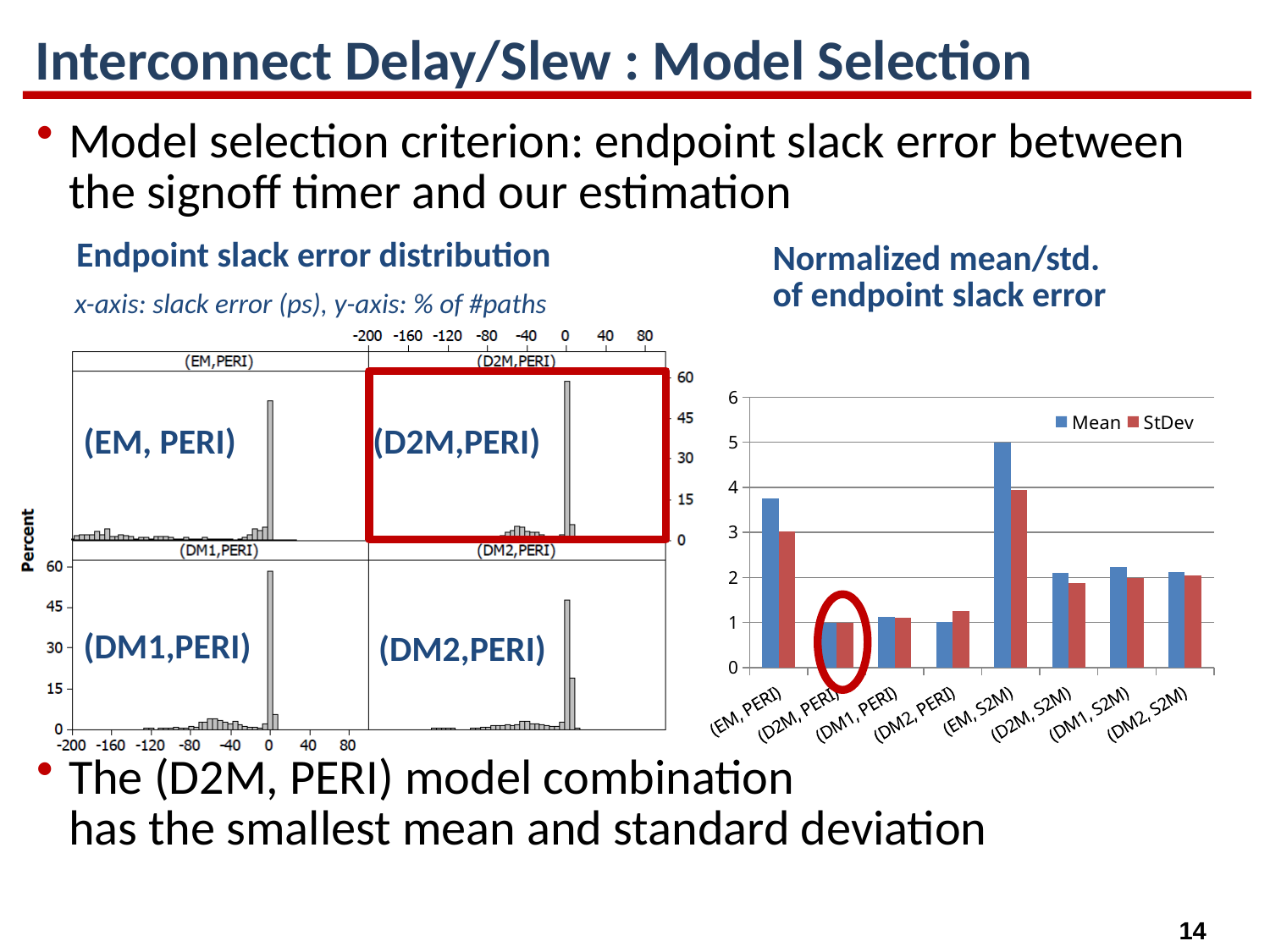
On the 'Normalized mean/std. of endpoint slack error' chart, how many series does the legend list? 2 On the 'Endpoint slack error distribution' chart, which panel is highlighted with a red box? (D2M,PERI) On the 'Normalized mean/std. of endpoint slack error' chart, is the Mean for (DM1, PERI) greater or less than 2? less On the 'Normalized mean/std. of endpoint slack error' chart, what kind of chart is shown? bar chart On the 'Normalized mean/std. of endpoint slack error' chart, what are the two legend entries? Mean and StDev On the 'Normalized mean/std. of endpoint slack error' chart, which is larger: the Mean for (EM, PERI) or the Mean for (DM2, PERI)? (EM, PERI) On the 'Normalized mean/std. of endpoint slack error' chart, which model combination has the highest StDev? (EM, S2M) On the 'Normalized mean/std. of endpoint slack error' chart, how many model combinations are shown on the x axis? 8 On the 'Normalized mean/std. of endpoint slack error' chart, is the Mean for (EM, S2M) greater or less than 4? greater On the 'Endpoint slack error distribution' chart, how many model combination panels are shown? 4 On the 'Normalized mean/std. of endpoint slack error' chart, is the Mean for (EM, PERI) greater or less than 3? greater On the 'Normalized mean/std. of endpoint slack error' chart, which model combination has the highest Mean? (EM, S2M)